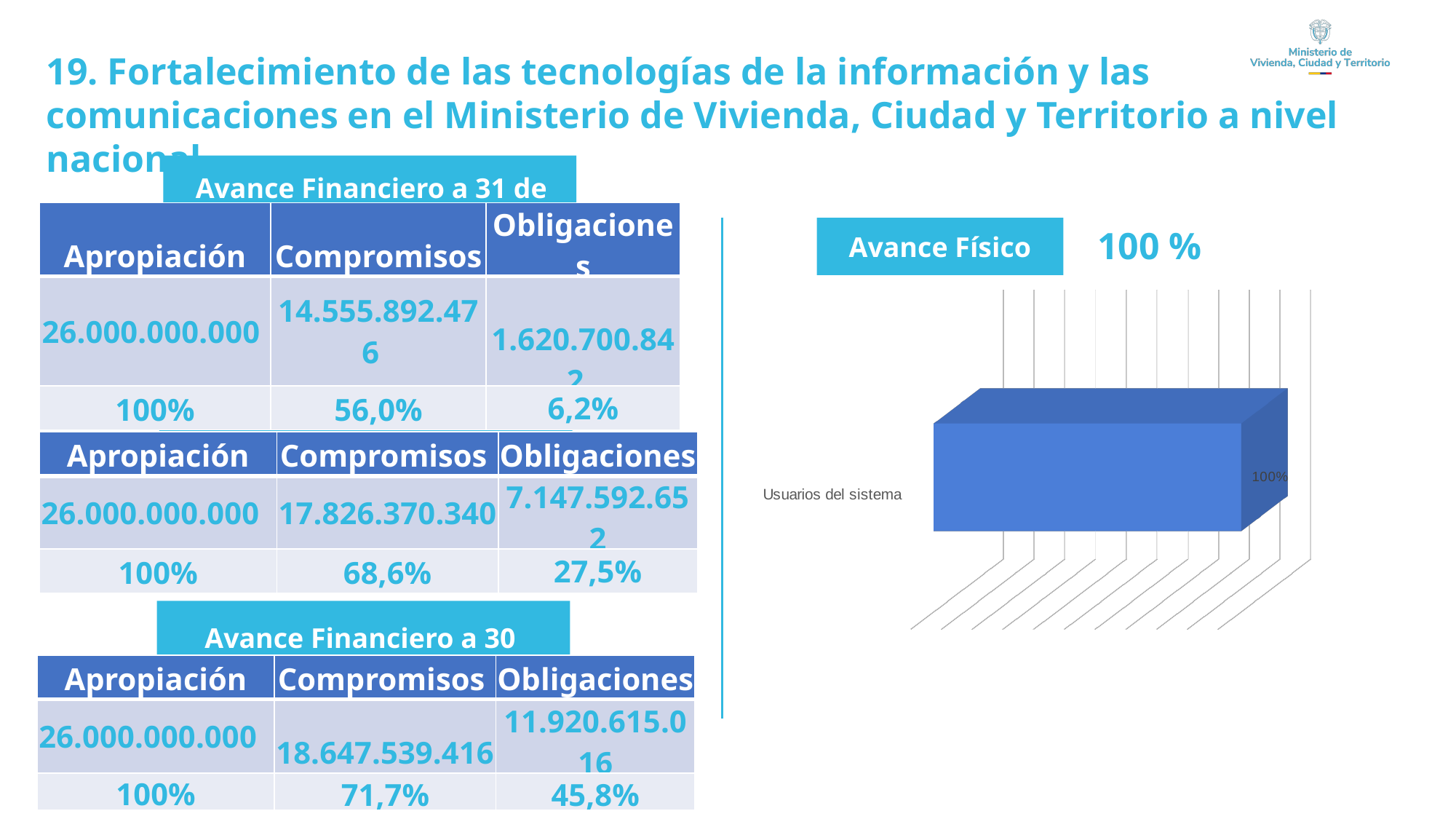
What is the name of the category plotted in the bar chart? Usuarios del sistema What kind of chart is shown on the right side of the slide? Bar chart What is the value shown for Usuarios del sistema in the bar chart? 100% How many categories are plotted in the bar chart on the right of the slide? 1 What colour is the bar in the chart on the right of the slide? Blue